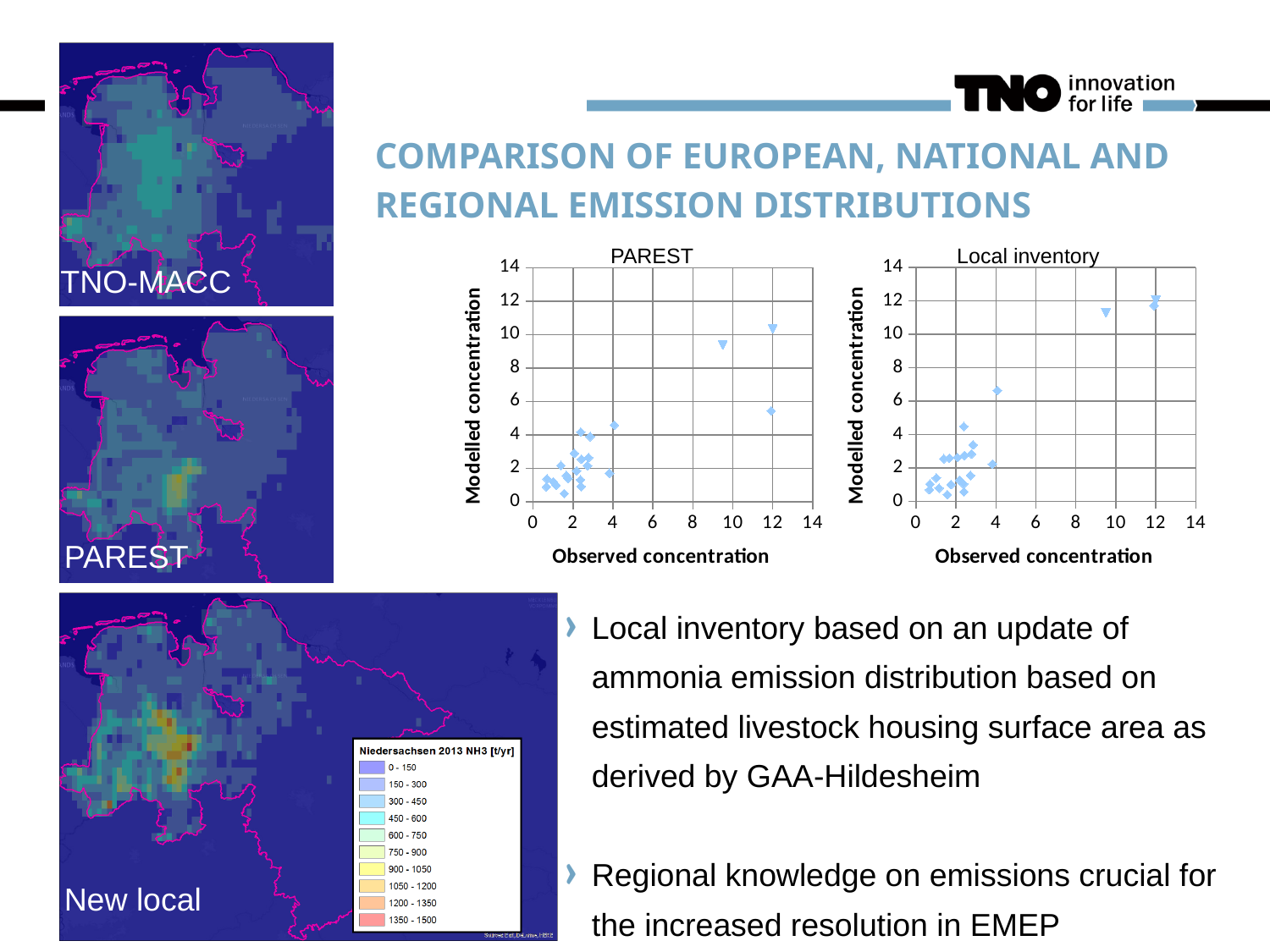
Which chart has the higher maximum modelled concentration, PAREST or Local inventory? Local inventory How many charts are shown on the slide? 2 In the Local inventory chart, is the highest modelled concentration greater or less than 10? greater What kind of chart is the Local inventory chart? Scatter chart In the PAREST chart, is the highest modelled concentration greater or less than 10? greater What is the title of the y axis on the Local inventory chart? Modelled concentration What is the title of the x axis on the PAREST chart? Observed concentration In the Local inventory chart, is the highest observed concentration greater or less than 10? greater What kind of chart is the PAREST chart? Scatter chart In the Local inventory chart, do modelled concentrations generally rise or fall as observed concentration increases? rise